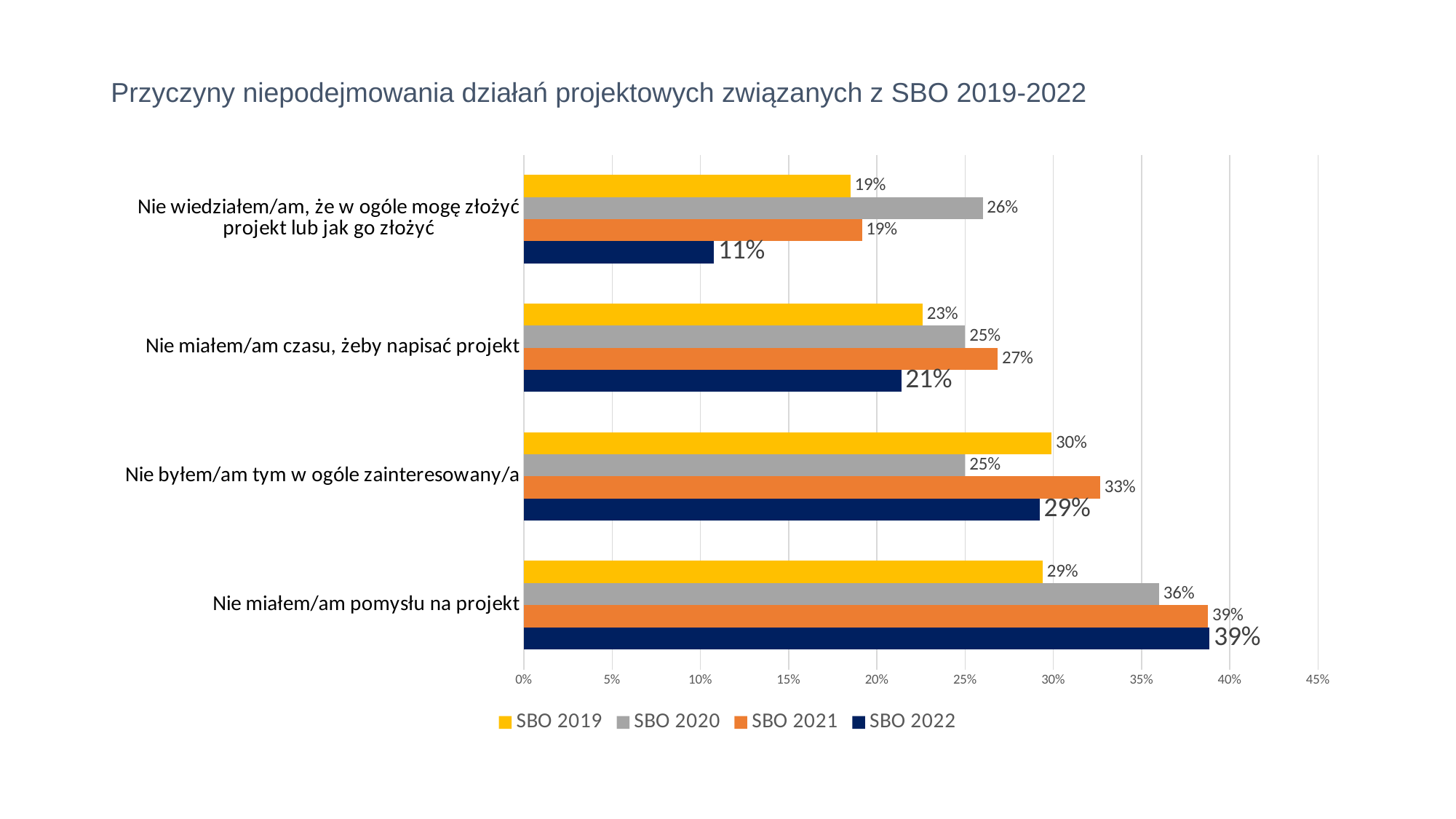
How many series does the legend list? 4 Which category has the lowest SBO 2019 value? Nie wiedziałem/am, że w ogóle mogę złożyć projekt lub jak go złożyć Which category has the highest SBO 2022 value? Nie miałem/am pomysłu na projekt What is the difference between the SBO 2021 and SBO 2019 values for "Nie miałem/am pomysłu na projekt"? 10% What is the SBO 2022 value for "Nie wiedziałem/am, że w ogóle mogę złożyć projekt lub jak go złożyć"? 11% How many categories are shown on the chart? 4 For "Nie miałem/am czasu, żeby napisać projekt", which is larger: the SBO 2021 value or the SBO 2022 value? SBO 2021 What is the title of the chart? Przyczyny niepodejmowania działań projektowych związanych z SBO 2019-2022 What is the SBO 2020 value for "Nie miałem/am pomysłu na projekt"? 36% What type of chart is shown on the slide? bar chart What is the SBO 2021 value for "Nie byłem/am tym w ogóle zainteresowany/a"? 33% What is the difference between the SBO 2020 and SBO 2022 values for "Nie wiedziałem/am, że w ogóle mogę złożyć projekt lub jak go złożyć"? 15%